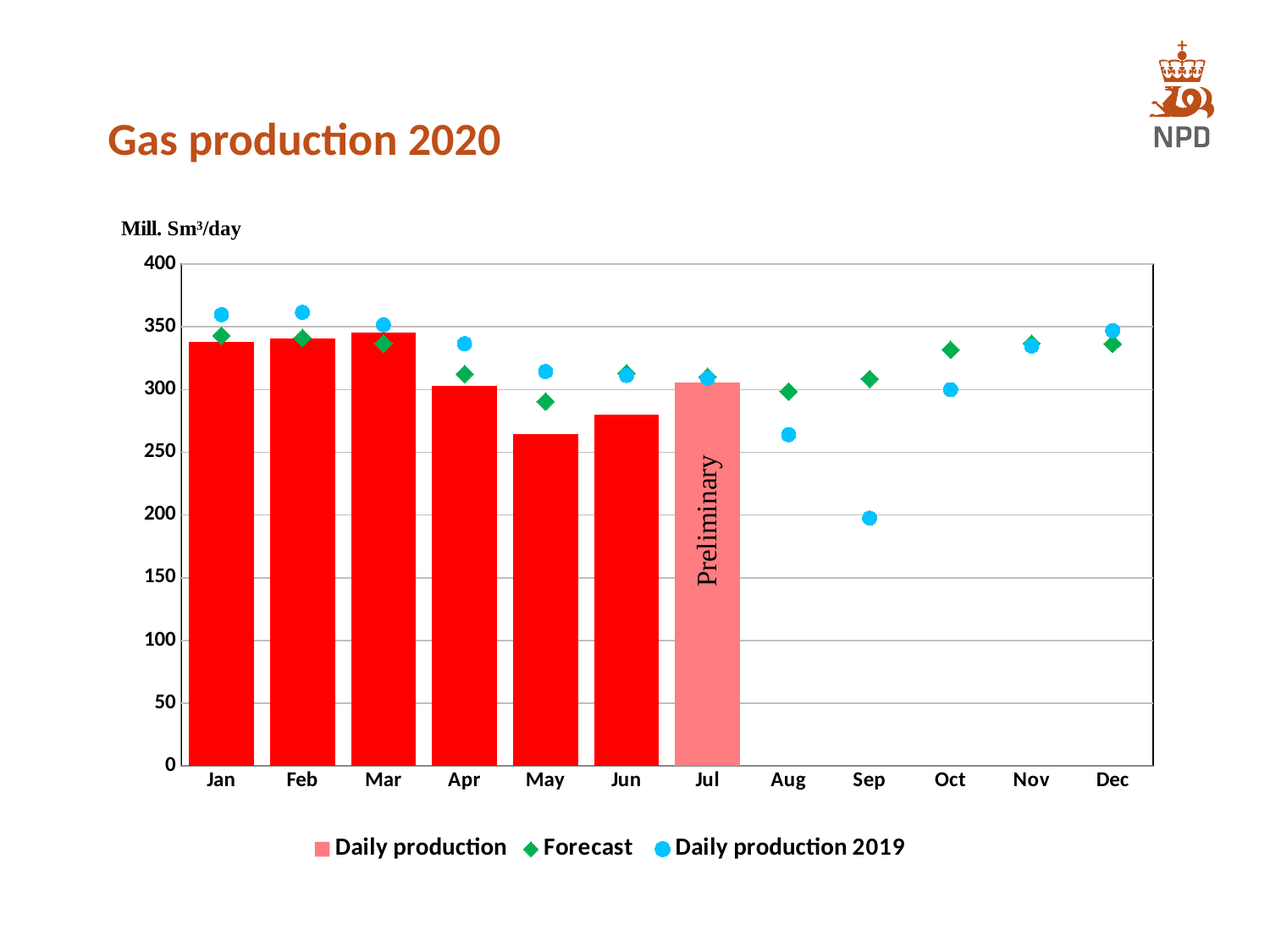
Which month has the lowest Daily production bar? May What kind of chart is shown on the slide? bar chart How many months have a Daily production bar plotted? 7 How many months are shown on the x axis? 12 What label is written on the Jul bar? Preliminary Do the Daily production bars rise or fall from Jan to May? fall Which is larger, the Daily production bar for Jan or for May? Jan Is the Daily production value for Jan greater or less than 300? greater Is the Daily production 2019 value for Sep greater or less than 250? less Is the Daily production value for May greater or less than 300? less How many series does the legend list? 3 Which month has the lowest Daily production 2019 value? Sep